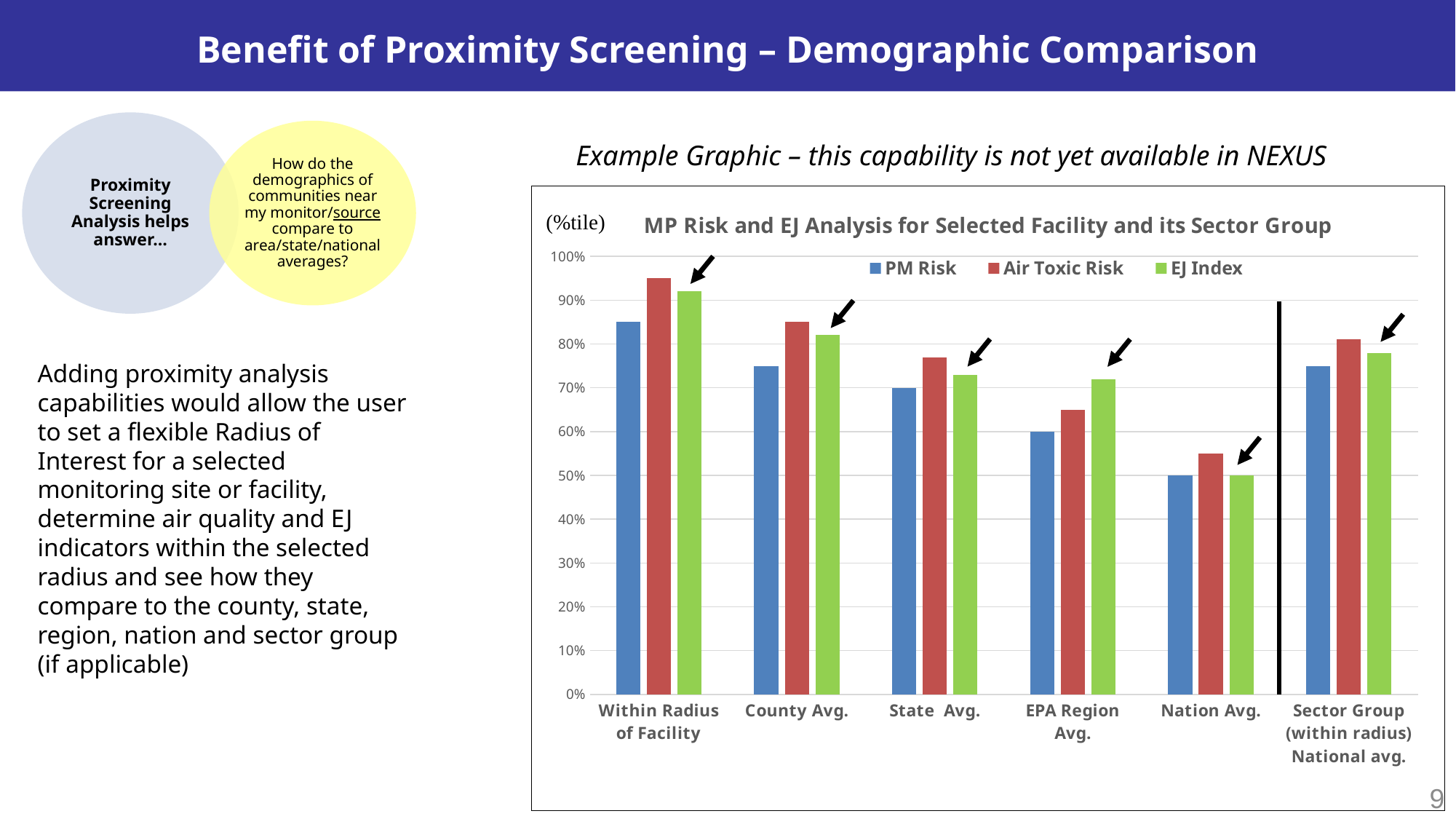
Is the Air Toxic Risk value for Nation Avg. greater or less than 60%? less Is the EJ Index value for Within Radius of Facility greater or less than 90%? greater Is the PM Risk value for County Avg. greater or less than 80%? less What is the title of the chart? MP Risk and EJ Analysis for Selected Facility and its Sector Group How many categories are shown along the x axis of the chart? 6 Which category has the highest Air Toxic Risk value? Within Radius of Facility Moving from Within Radius of Facility to Nation Avg., do the Air Toxic Risk values rise or fall? fall For Within Radius of Facility, which is larger: PM Risk or Air Toxic Risk? Air Toxic Risk How many series does the chart legend list? 3 What kind of chart is shown on the slide? bar chart Which category has the lowest EJ Index value? Nation Avg.